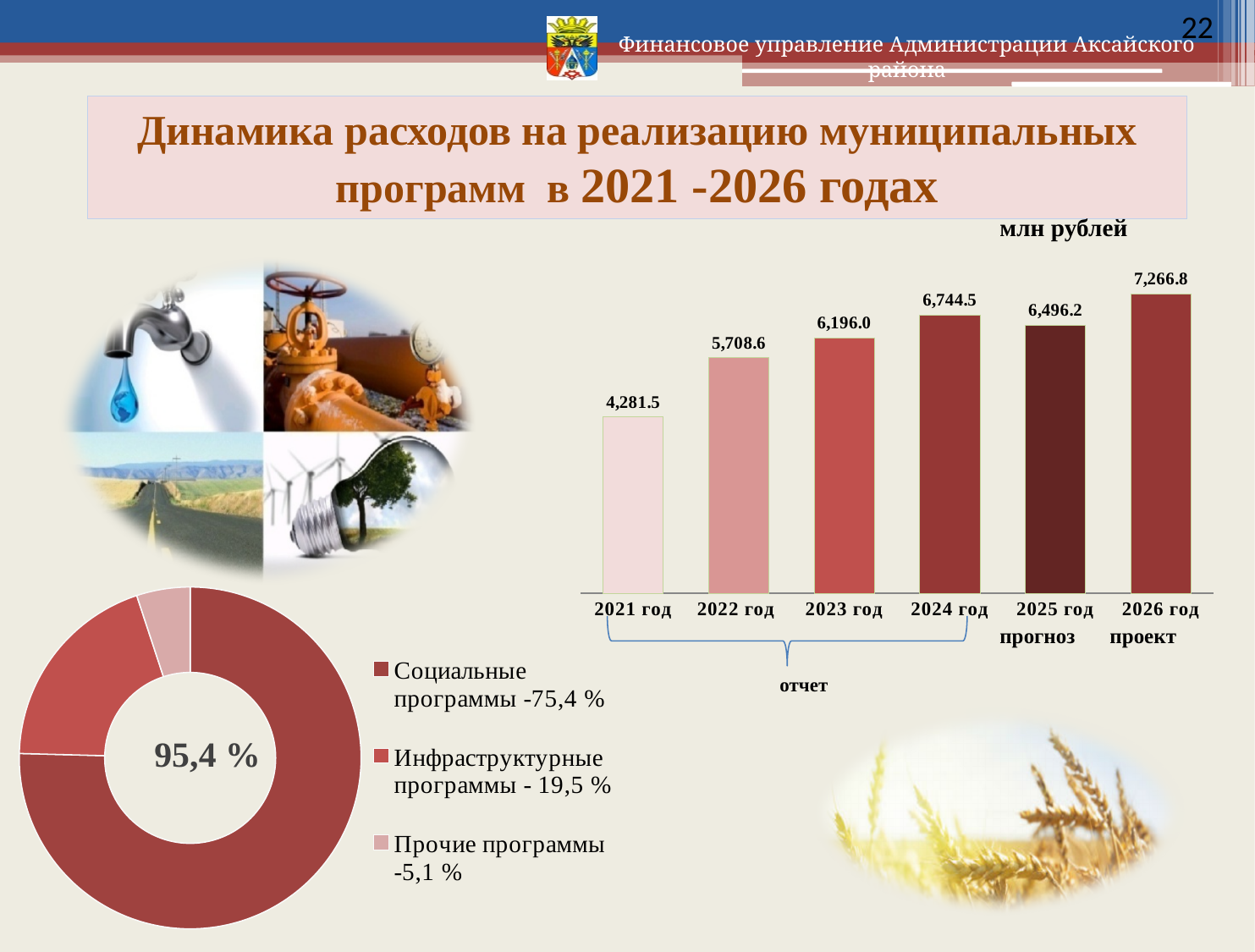
What unit is stated for the bar chart values? млн рублей On the bar chart, which is larger: the value for 2024 год or the value for 2025 год? 2024 год On the bar chart, what is the value for 2021 год? 4,281.5 On the bar chart, what is the difference between the values for 2024 год and 2025 год? 248.3 On the bar chart, what is the value for 2025 год (прогноз)? 6,496.2 On the donut chart, which category has the smallest share? Прочие программы On the donut chart, what share do Инфраструктурные программы have? 19,5 % On the bar chart, which year has the lowest value? 2021 год On the bar chart, does the value rise or fall from 2024 год to 2025 год? fall On the bar chart, what is the difference between the values for 2026 год and 2021 год? 2,985.3 On the bar chart, which year has the highest value? 2026 год How many years (bars) are shown on the bar chart? 6